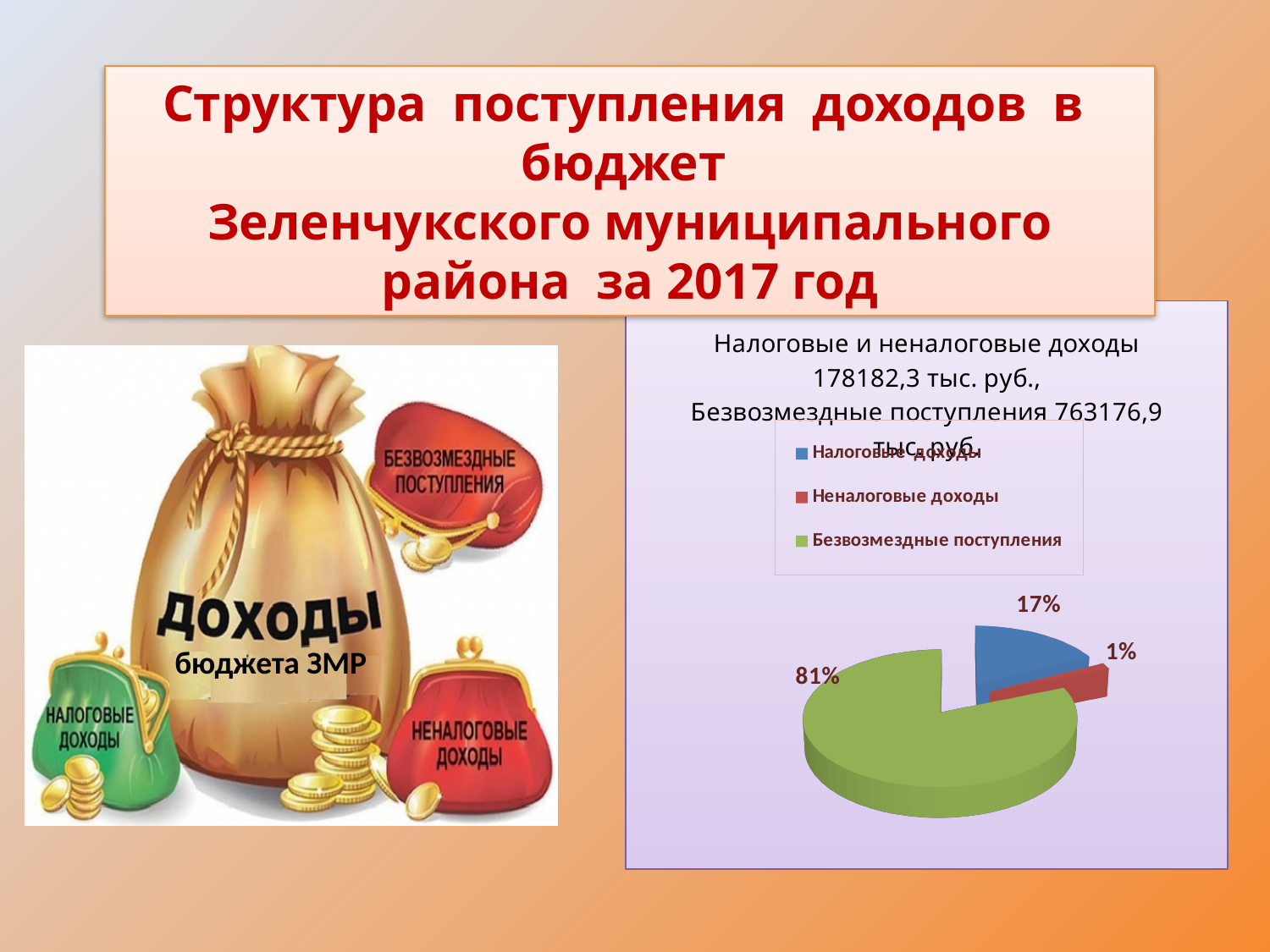
What kind of chart is shown on the slide? pie chart Which slice is larger, Налоговые доходы or Неналоговые доходы? Налоговые доходы Which category has the largest slice of the pie? Безвозмездные поступления How many slices does the pie chart have? 3 Which category has the smallest slice of the pie? Неналоговые доходы What is the difference in percentage points between the Безвозмездные поступления slice and the Налоговые доходы slice? 64 What share of the pie does Налоговые доходы have? 17% What colour is the Безвозмездные поступления slice in the pie chart? green What share of the pie does Безвозмездные поступления have? 81% How many entries does the legend list? 3 What share of the pie does Неналоговые доходы have? 1% According to the chart title, what is the amount of Безвозмездные поступления in тыс. руб.? 763176,9 тыс. руб.